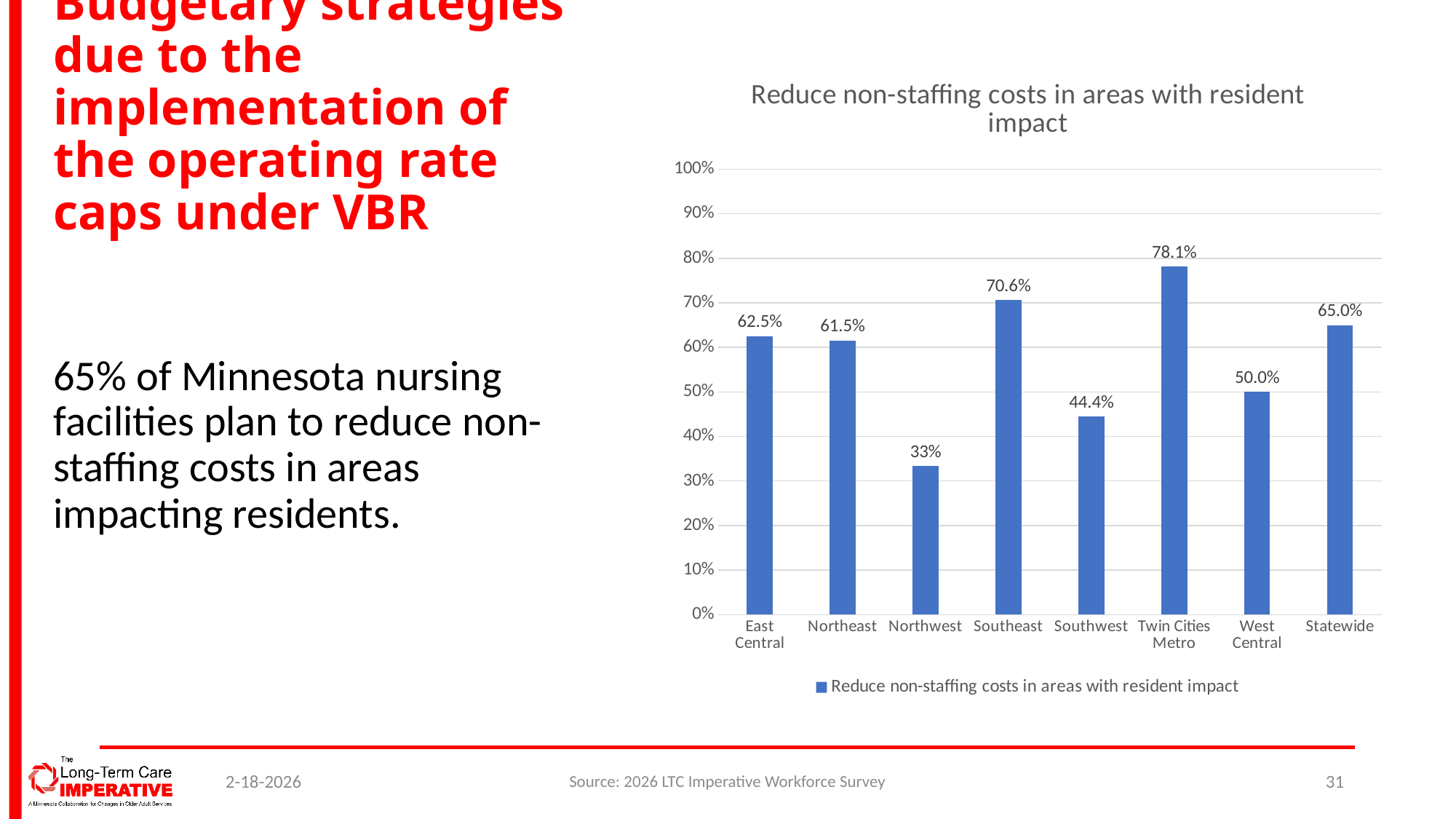
Which is larger, the value for Southeast or the value for West Central? Southeast What kind of chart is shown on the slide? bar chart What is the title of the chart? Reduce non-staffing costs in areas with resident impact What is the value for Twin Cities Metro? 78.1% What is the value for Southwest? 44.4% How many categories are shown on the x axis? 8 What is the value for Northwest? 33% What is the Statewide value? 65.0% What is the difference between the Twin Cities Metro value and the Northwest value? 45.1% Which region has the highest value? Twin Cities Metro Which region has the lowest value? Northwest Is the value for Southwest greater or less than 50%? less